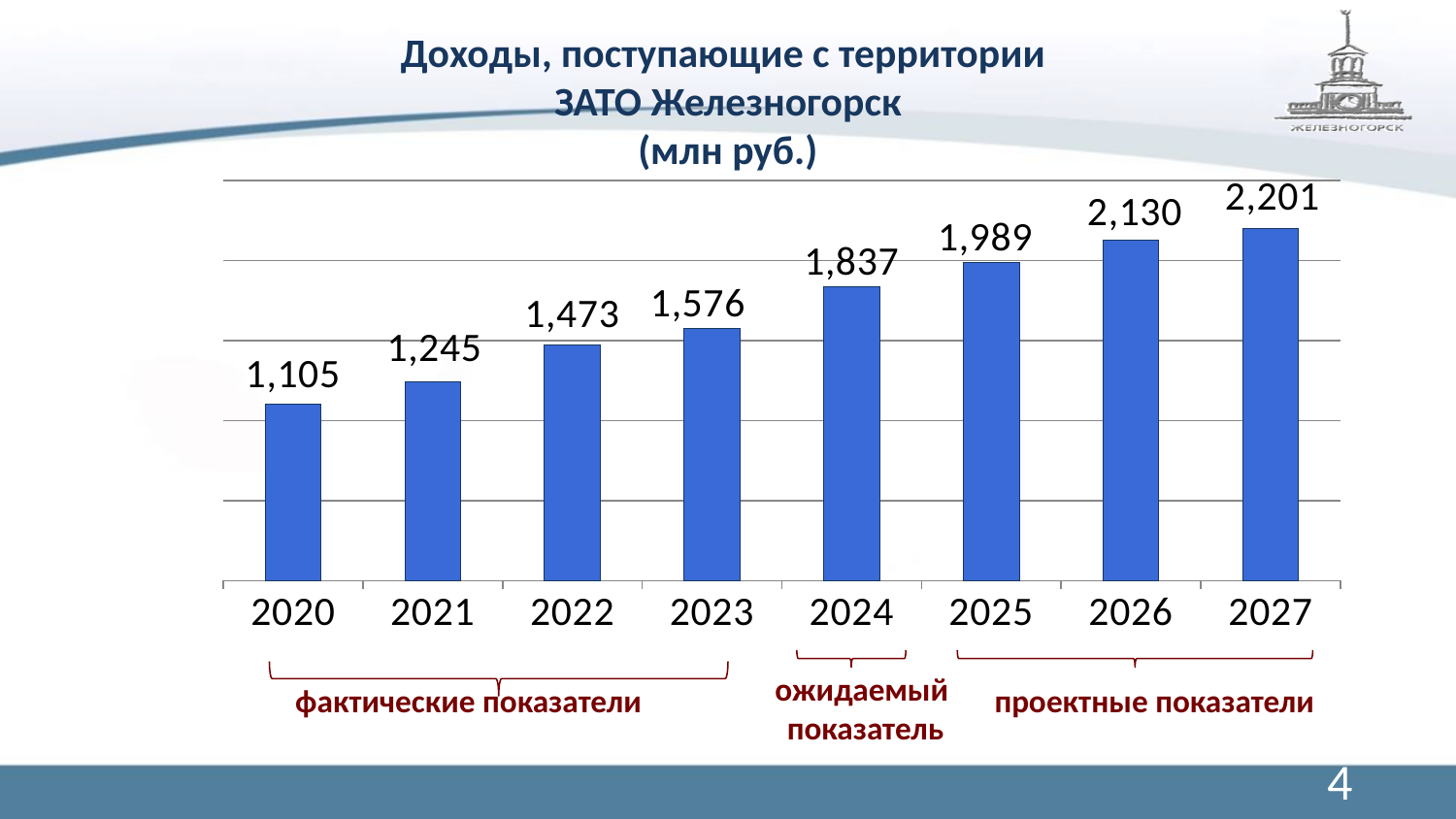
What is the value for 2027? 2,201 What is the difference between the values for 2027 and 2020? 1,096 Which is larger, the value for 2025 or the value for 2023? 2025 What unit is given in the chart title? млн руб. What is the value for 2024? 1,837 What is the difference between the values for 2023 and 2022? 103 Do the values rise or fall from 2020 to 2027? rise How many years are shown on the x axis? 8 Which year has the lowest value? 2020 What kind of chart is shown on the slide? bar chart What is the value for 2020? 1,105 Which year has the highest value? 2027